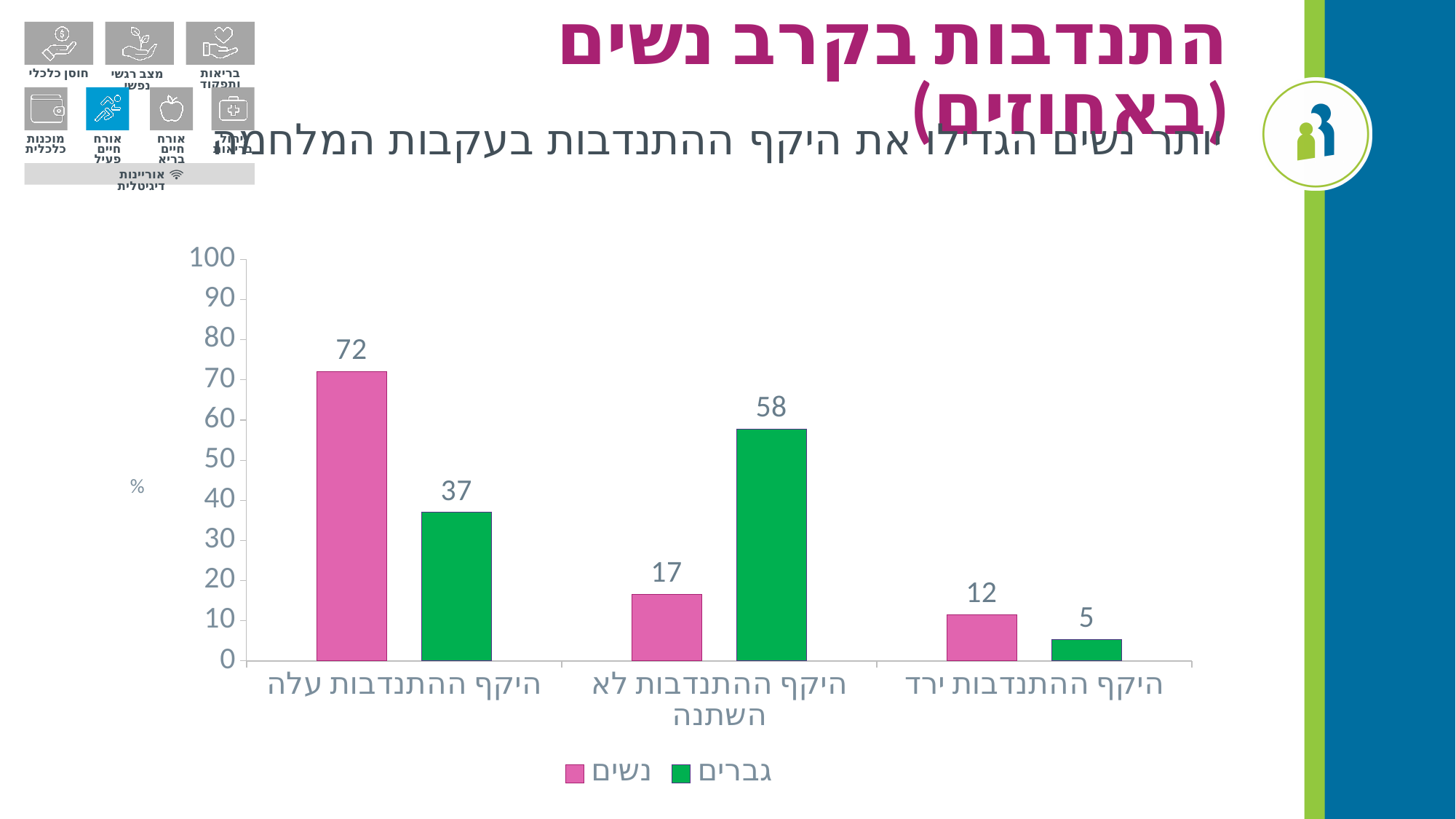
In which category is the value for גברים lowest? היקף ההתנדבות ירד Which colour represents the series נשים in the chart? pink What is the value for נשים in the category היקף ההתנדבות עלה? 72 In which category is the value for נשים highest? היקף ההתנדבות עלה What is the value for גברים in the category היקף ההתנדבות לא השתנה? 58 How many categories are shown on the x axis? 3 What is the value for גברים in the category היקף ההתנדבות ירד? 5 What kind of chart is shown on the slide? bar chart How many series does the legend list? 2 What is the difference between the נשים and גברים values in the category היקף ההתנדבות עלה? 35 Which is larger in the category היקף ההתנדבות לא השתנה: the value for נשים or for גברים? גברים What is the value for נשים in the category היקף ההתנדבות ירד? 12